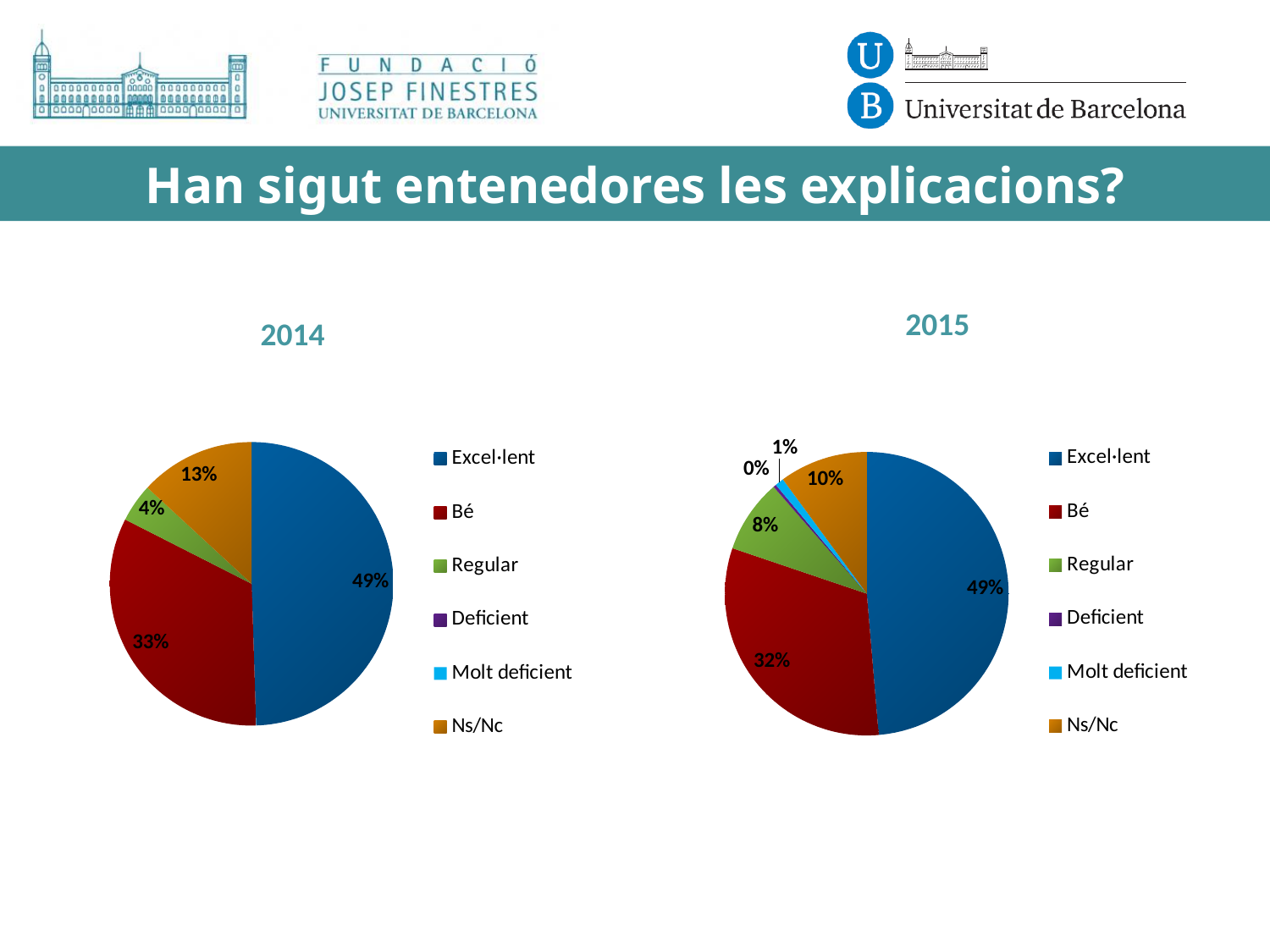
What type of chart is used for the 2014 data? Pie chart In the 2015 pie chart, what percentage is shown for Regular? 8% In the 2014 pie chart, what percentage is shown for Bé? 33% In the 2015 pie chart, what percentage is shown for Ns/Nc? 10% What is the difference between the Bé share in 2014 and the Bé share in 2015? 1% In the 2015 pie chart, what percentage is shown for Bé? 32% In the 2014 pie chart, what percentage is shown for Ns/Nc? 13% Which is larger: the Regular share in 2014 or the Regular share in 2015? 2015 In the 2014 pie chart, what percentage is shown for Excel·lent? 49% In the 2015 pie chart, which category has the largest share? Excel·lent How many entries does the legend of the 2015 chart list? 6 In the 2014 pie chart, which category has the largest share? Excel·lent